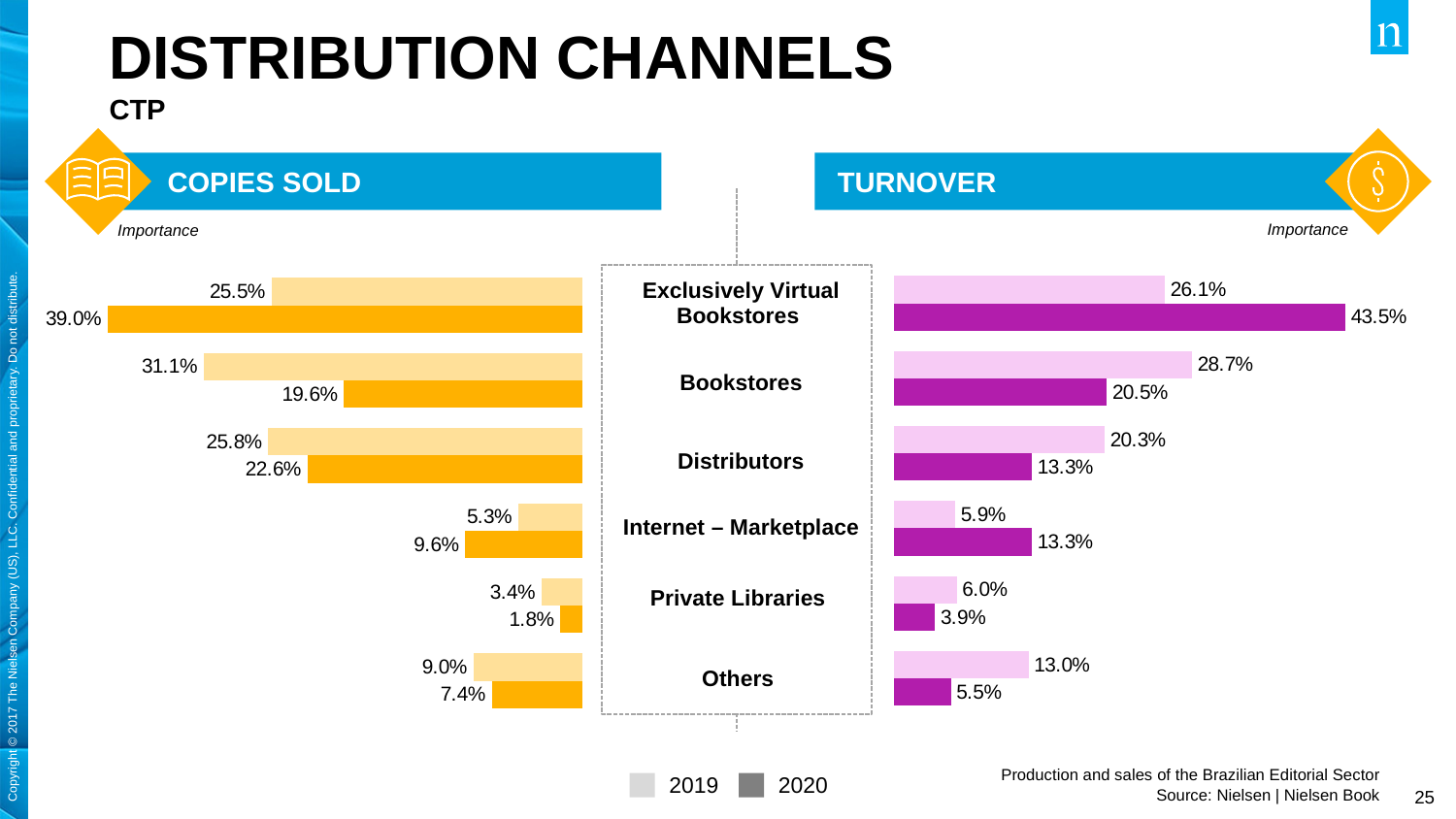
In the TURNOVER chart, which is larger for Internet – Marketplace: the 2019 value or the 2020 value? 2020 In the COPIES SOLD chart, which category has the lowest value in 2020? Private Libraries What kind of chart is the TURNOVER chart? Bar chart In the TURNOVER chart, what is the value for Bookstores in 2019? 28.7% In the COPIES SOLD chart, what is the value for Exclusively Virtual Bookstores in 2020? 39.0% How many series does the legend list? 2 How many categories are shown in the COPIES SOLD chart? 6 In the COPIES SOLD chart, what is the value for Distributors in 2019? 25.8% In the COPIES SOLD chart, which is larger for Bookstores: the 2019 value or the 2020 value? 2019 In the TURNOVER chart, what is the difference between the 2019 and 2020 values for Others? 7.5% In the TURNOVER chart, which category has the highest value in 2020? Exclusively Virtual Bookstores In the COPIES SOLD chart, what is the difference between the 2020 and 2019 values for Exclusively Virtual Bookstores? 13.5%